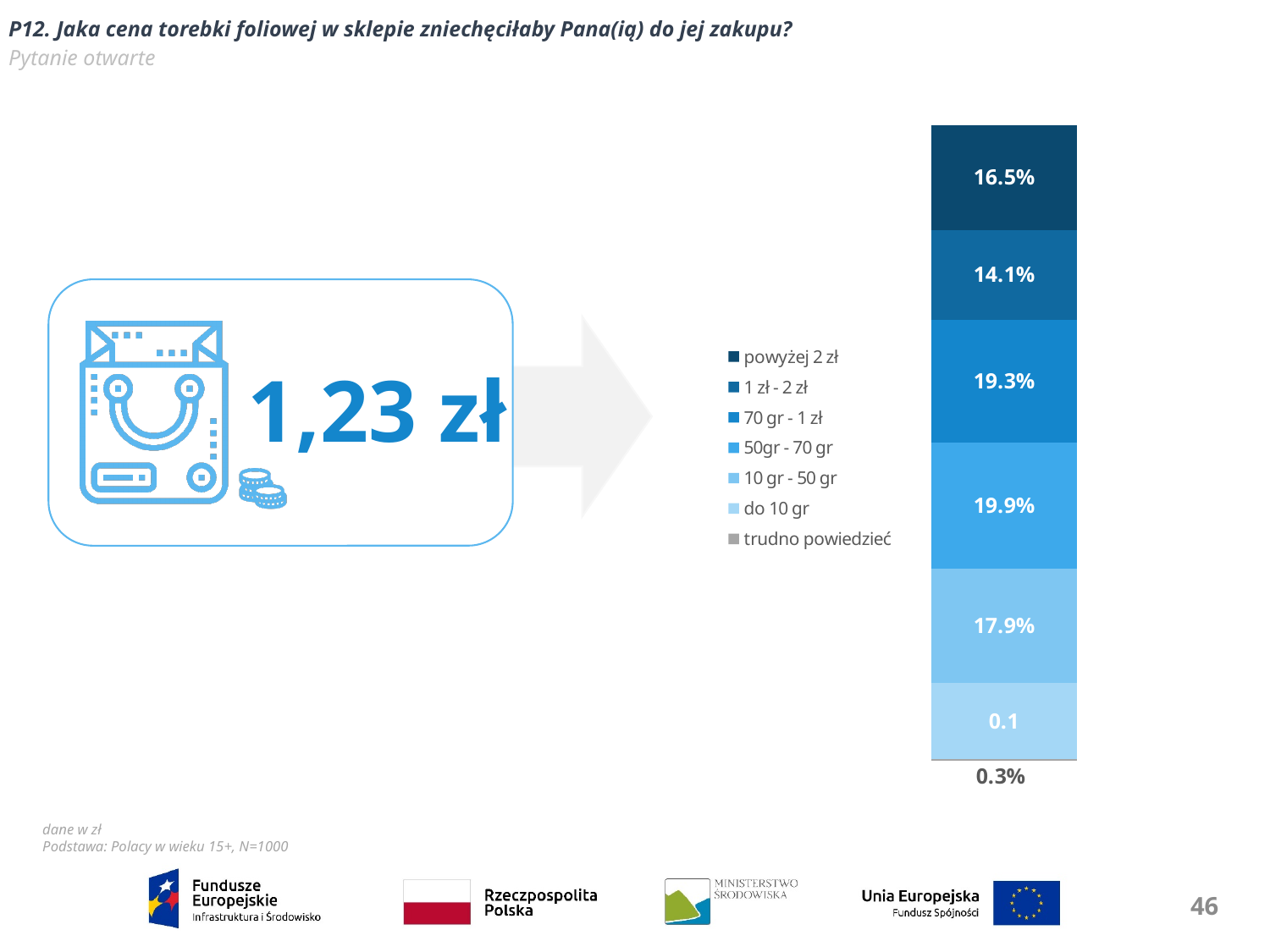
What value is printed below the bar for 'trudno powiedzieć'? 0.3% What percentage is shown for the '70 gr - 1 zł' segment? 19.3% Which price range has the largest share in the stacked bar? 50gr - 70 gr Which is larger, the share for 'powyżej 2 zł' or for '1 zł - 2 zł'? powyżej 2 zł What percentage is shown for the 'powyżej 2 zł' segment of the stacked bar? 16.5% How many entries does the chart legend list? 7 What percentage is shown for the '10 gr - 50 gr' segment? 17.9% What is the difference between the 'powyżej 2 zł' share and the '1 zł - 2 zł' share? 2.4 percentage points What is the difference between the '50gr - 70 gr' share and the '70 gr - 1 zł' share? 0.6 percentage points What type of chart is used to show the price ranges? Stacked bar chart What percentage is shown for the '1 zł - 2 zł' segment? 14.1% What percentage is shown for the '50gr - 70 gr' segment? 19.9%